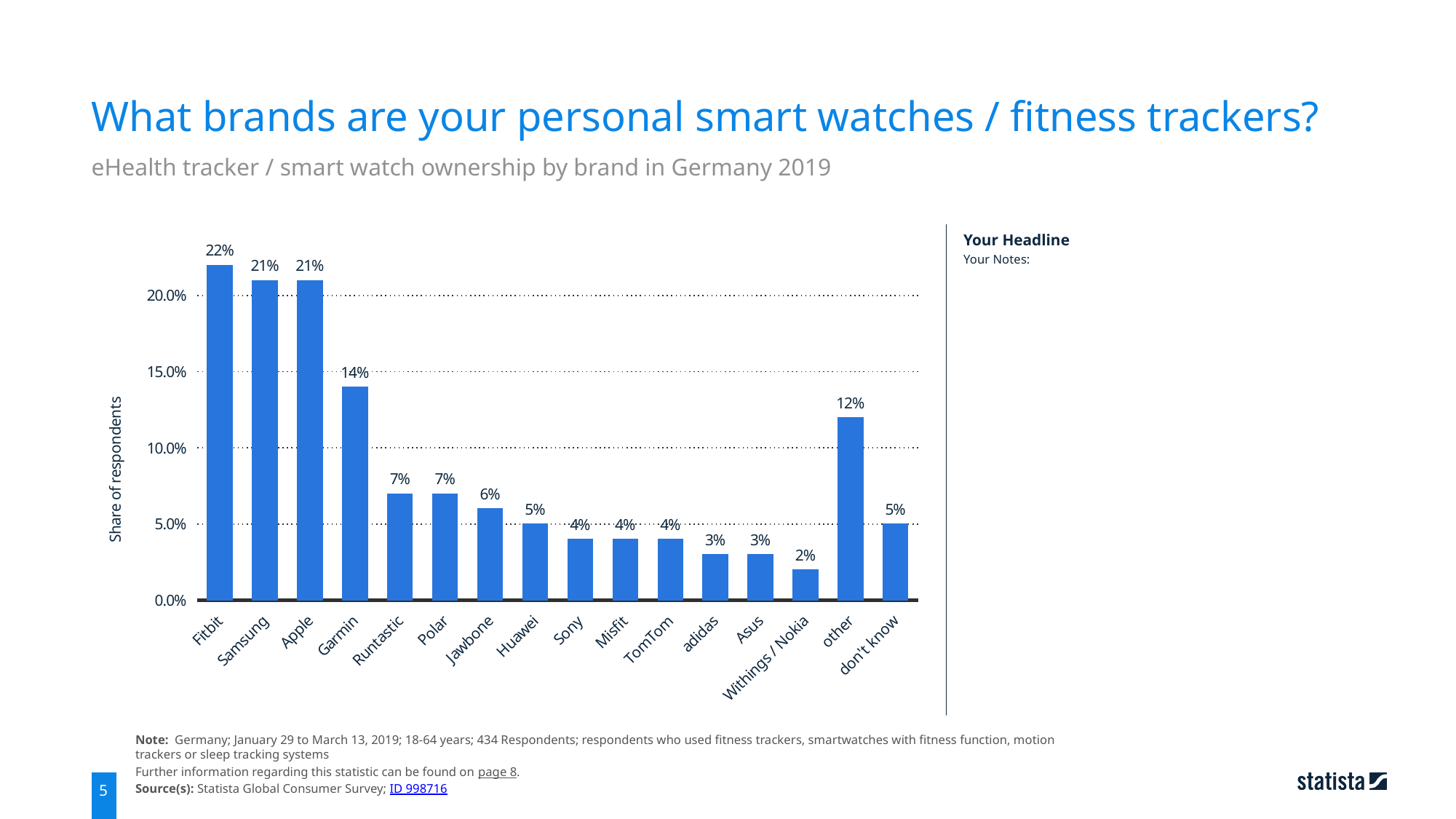
Which brand has the highest share of respondents? Fitbit What kind of chart is shown on the slide? Bar chart What is the value shown for Garmin? 14% Which category has the lowest share of respondents? Withings / Nokia How many categories are shown on the x axis? 16 What is the value shown for Withings / Nokia? 2% What is the label of the y axis? Share of respondents What share of respondents answered 'other'? 12% Is the value for Runtastic greater or less than 5.0%? greater What is the difference between the values for Fitbit and Garmin? 8% Which has a larger share of respondents, Jawbone or Huawei? Jawbone What share of respondents own a Fitbit smart watch / fitness tracker? 22%